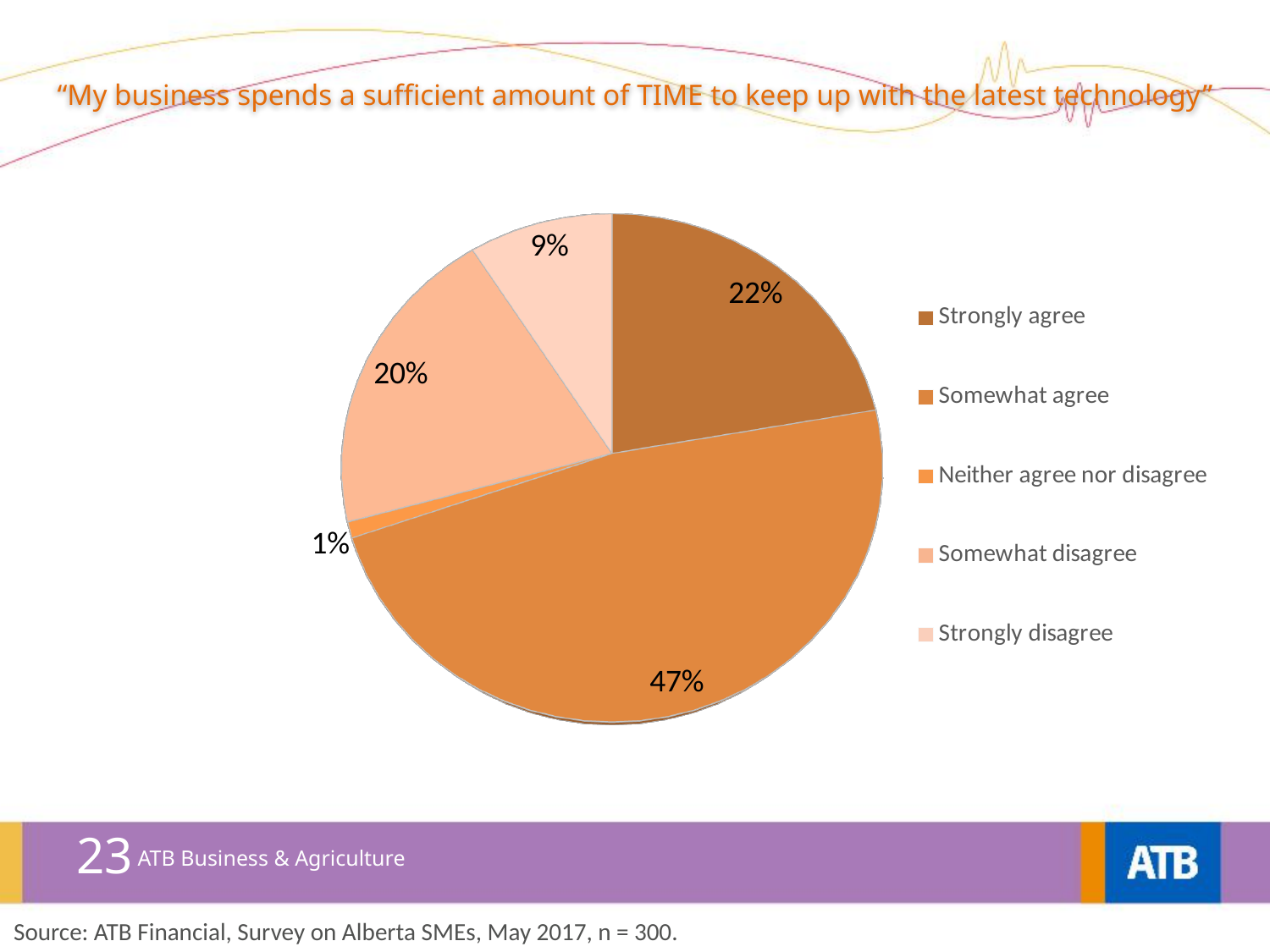
What percentage of respondents strongly agree? 22% What kind of chart is shown on the slide? Pie chart What share of respondents somewhat agree that their business spends a sufficient amount of time to keep up with the latest technology? 47% What is the combined share of respondents who strongly agree or somewhat agree? 69% How many response categories does the legend list? 5 Which response category has the smallest share of the pie? Neither agree nor disagree Which is larger, the share for 'Somewhat disagree' or the share for 'Strongly disagree'? Somewhat disagree Which response category has the largest share of the pie? Somewhat agree What is the difference in percentage points between 'Somewhat agree' and 'Strongly agree'? 25 What percentage of respondents somewhat disagree? 20% What percentage of respondents strongly disagree? 9% What percentage of respondents neither agree nor disagree? 1%